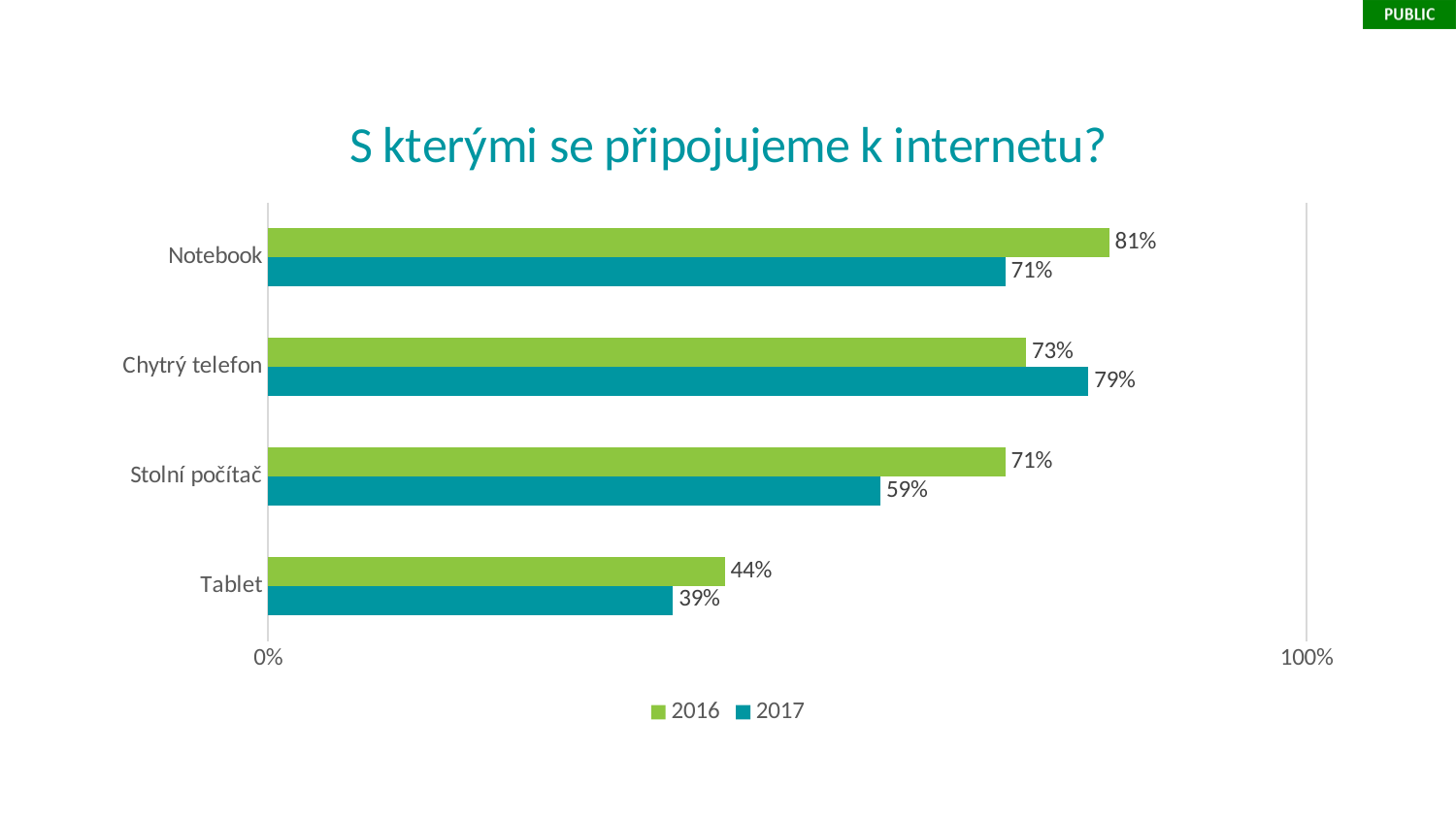
What kind of chart is shown on the slide? Bar chart What is the 2017 value for Stolní počítač? 59% What is the 2016 value for Tablet? 44% What is the 2016 value for Notebook? 81% How many categories are shown on the chart? 4 What is the 2017 value for Chytrý telefon? 79% Which is larger for Stolní počítač, the 2016 value or the 2017 value? 2016 Which category has the highest 2017 value? Chytrý telefon Which category has the lowest 2016 value? Tablet What is the difference between the 2016 and 2017 values for Notebook? 10% How many series does the legend list? 2 What is the title of the chart? S kterými se připojujeme k internetu?